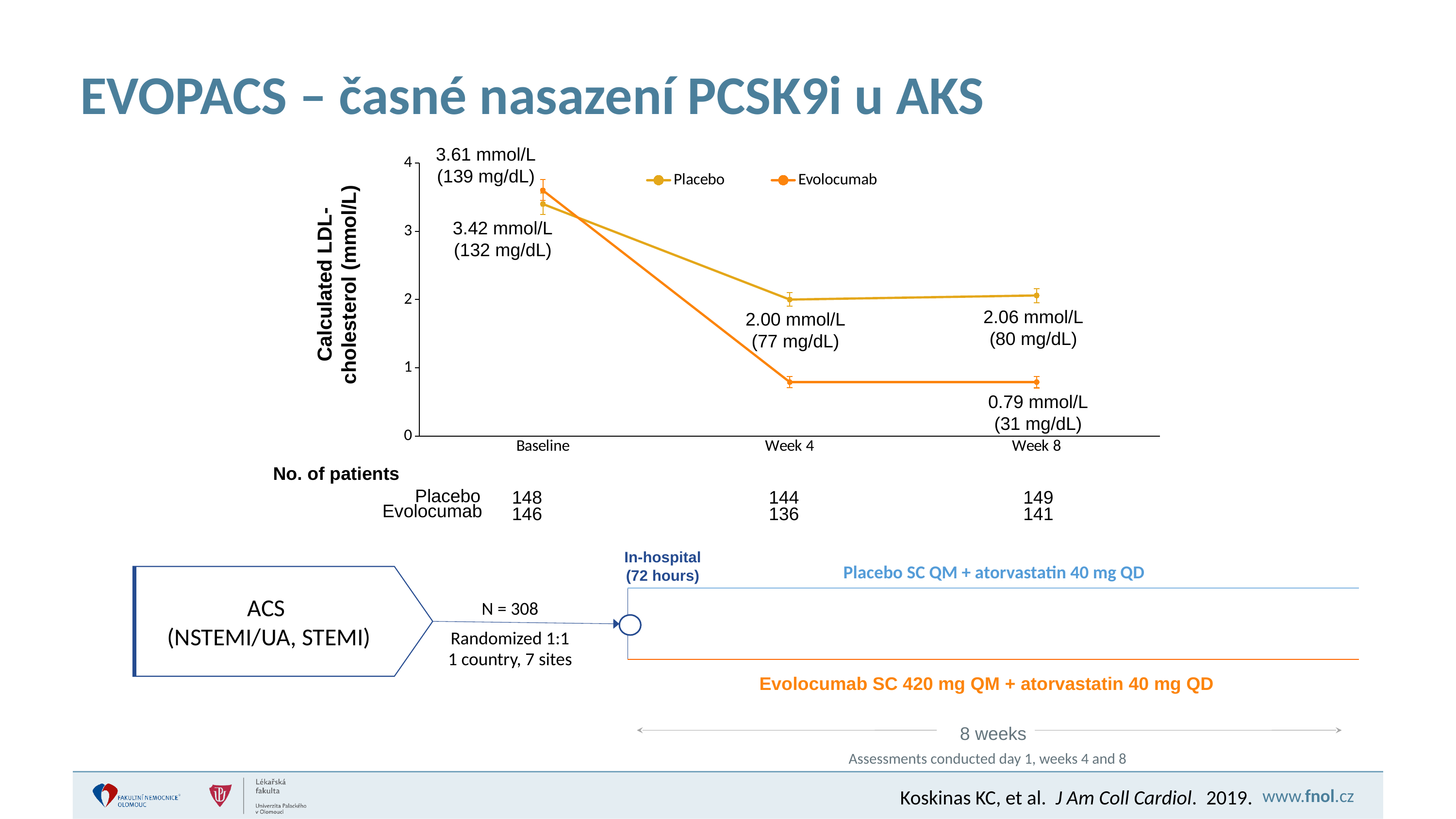
What is the label of the y axis of the chart? Calculated LDL-cholesterol (mmol/L) What is the difference in LDL-cholesterol between Placebo and Evolocumab at Week 8, in mmol/L? 1.27 mmol/L What is the calculated LDL-cholesterol for Placebo at Week 4? 2.00 mmol/L How many time points are plotted along the x axis of the chart? 3 What kind of chart is shown on the slide? line chart How many series does the chart legend list? 2 What is the Evolocumab LDL-cholesterol value at Week 8 expressed in mg/dL? 31 mg/dL At Week 8, which series has the higher LDL-cholesterol value, Placebo or Evolocumab? Placebo Is the Evolocumab LDL-cholesterol value at Week 4 greater or less than 1? less What is the calculated LDL-cholesterol for Placebo at Week 8? 2.06 mmol/L Does the Evolocumab LDL-cholesterol value rise or fall from Baseline to Week 8? fall What is the calculated LDL-cholesterol for Evolocumab at Week 8? 0.79 mmol/L